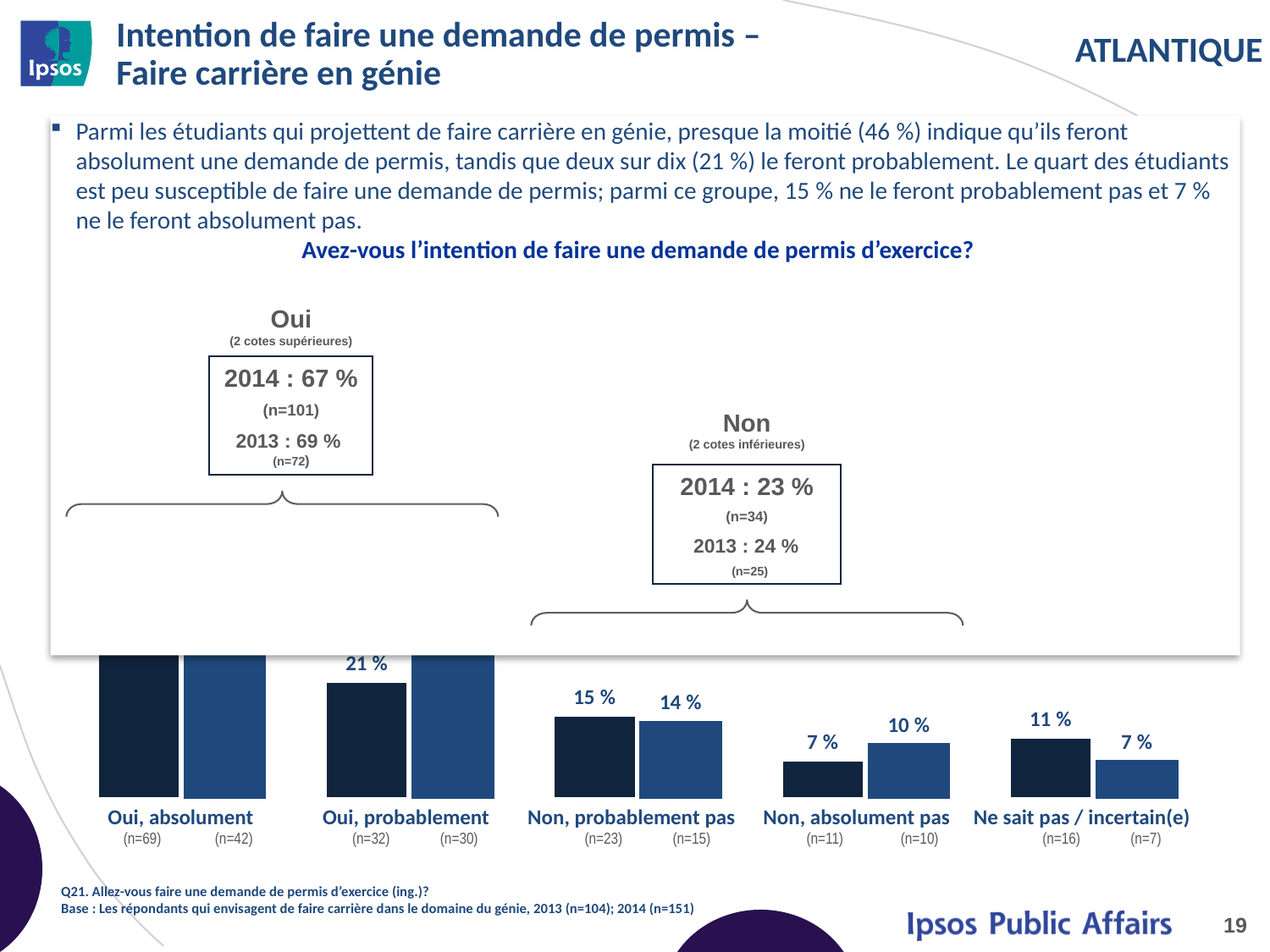
How many response categories are shown along the x axis of the chart? 5 What is the value of the right (lighter) bar for "Non, absolument pas"? 10 % What is the value of the left (dark) bar for "Oui, probablement"? 21 % For "Non, absolument pas", which bar is larger, the left (dark) one or the right (lighter) one? The right (lighter) bar What type of chart is used on this slide? Bar chart Which category has the lowest value for the left (dark) bar? Non, absolument pas What is the value of the right (lighter) bar for "Ne sait pas / incertain(e)"? 7 % What is the value of the right (lighter) bar for "Non, probablement pas"? 14 % What is the value of the left (dark) bar for "Ne sait pas / incertain(e)"? 11 % What is the difference between the left and right bars for "Ne sait pas / incertain(e)"? 4 % What is the value of the left (dark) bar for "Non, probablement pas"? 15 % What is the value of the left (dark) bar for "Non, absolument pas"? 7 %